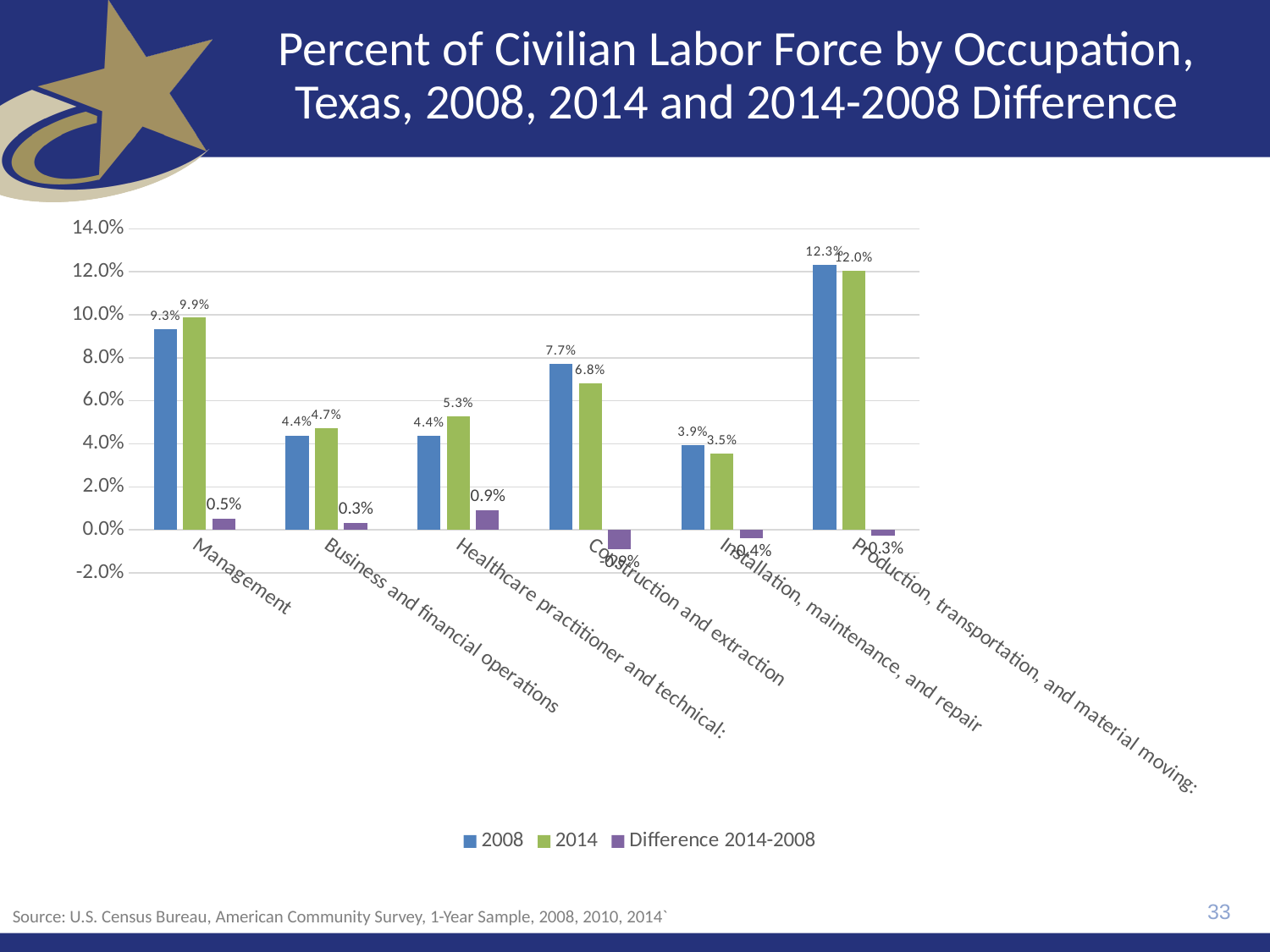
What is the 2008 value for Management? 9.3% Which occupation has the lowest 2008 value? Installation, maintenance, and repair What is the Difference 2014-2008 value for Healthcare practitioner and technical? 0.9% What is the 2014 value for Healthcare practitioner and technical? 5.3% How many occupation categories are shown on the x axis? 6 Which occupation has the highest 2014 value? Production, transportation, and material moving How many series does the legend list? 3 For Management, which is larger, the 2008 value or the 2014 value? 2014 What colour represents the 2014 series in the legend? green Is the 2008 value for Production, transportation, and material moving greater or less than 10.0%? greater What kind of chart is shown on the slide? bar chart What is the difference between the 2008 and 2014 values for Construction and extraction? 0.9%